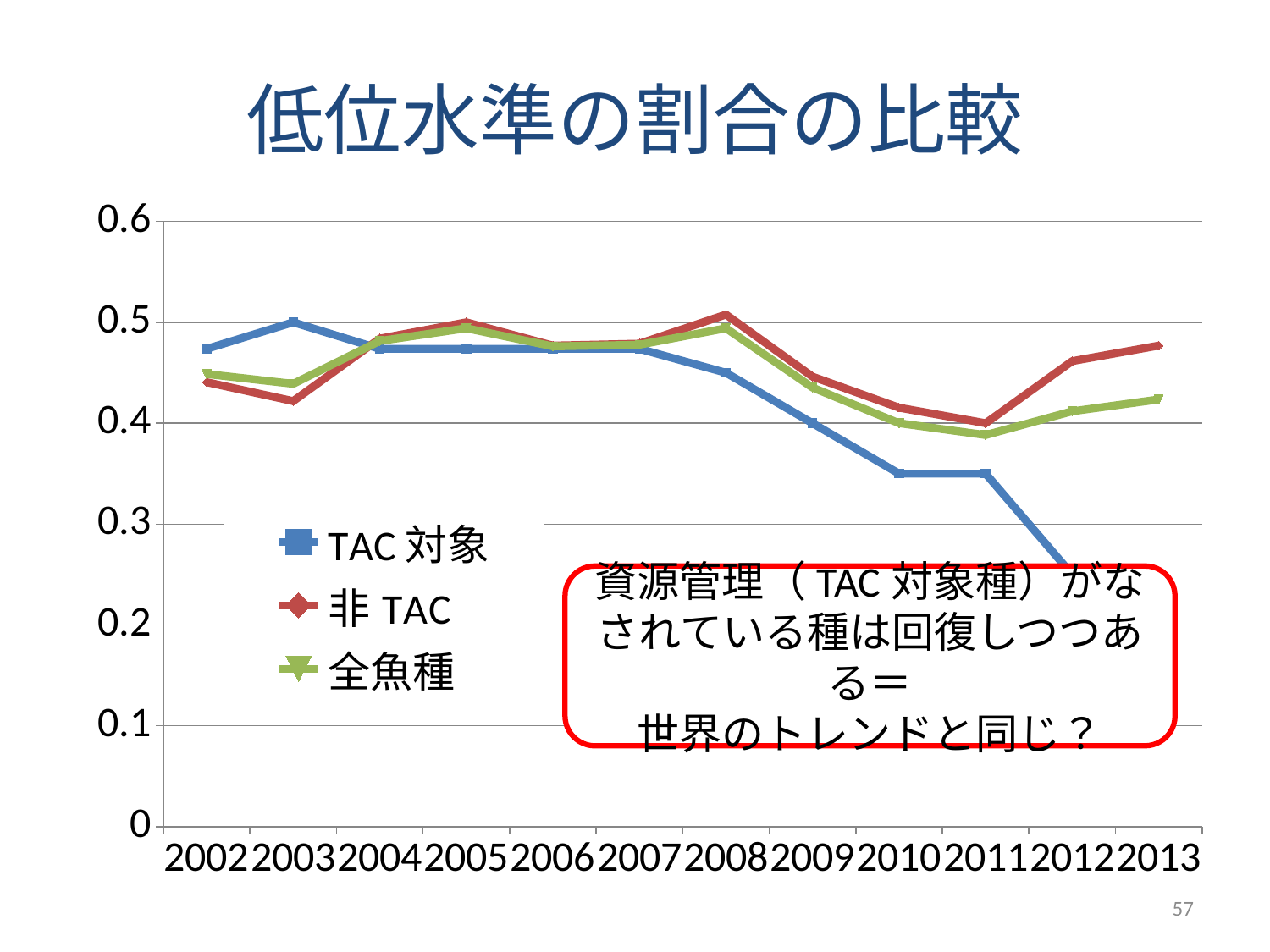
Does the TAC 対象 series rise or fall from 2008 to 2011? fall How many years are shown on the x axis? 12 In 2010, which is larger: the value for 非 TAC or the value for TAC 対象? 非 TAC Is the value for TAC 対象 in 2010 greater or less than 0.4? less In 2010, which series has the lowest value? TAC 対象 How many series does the legend list? 3 Is the value for TAC 対象 in 2011 greater or less than 0.4? less What kind of chart is shown on the slide? line chart Is the value for 非 TAC in 2013 greater or less than 0.4? greater Which series is drawn in blue? TAC 対象 What is the title of the chart? 低位水準の割合の比較